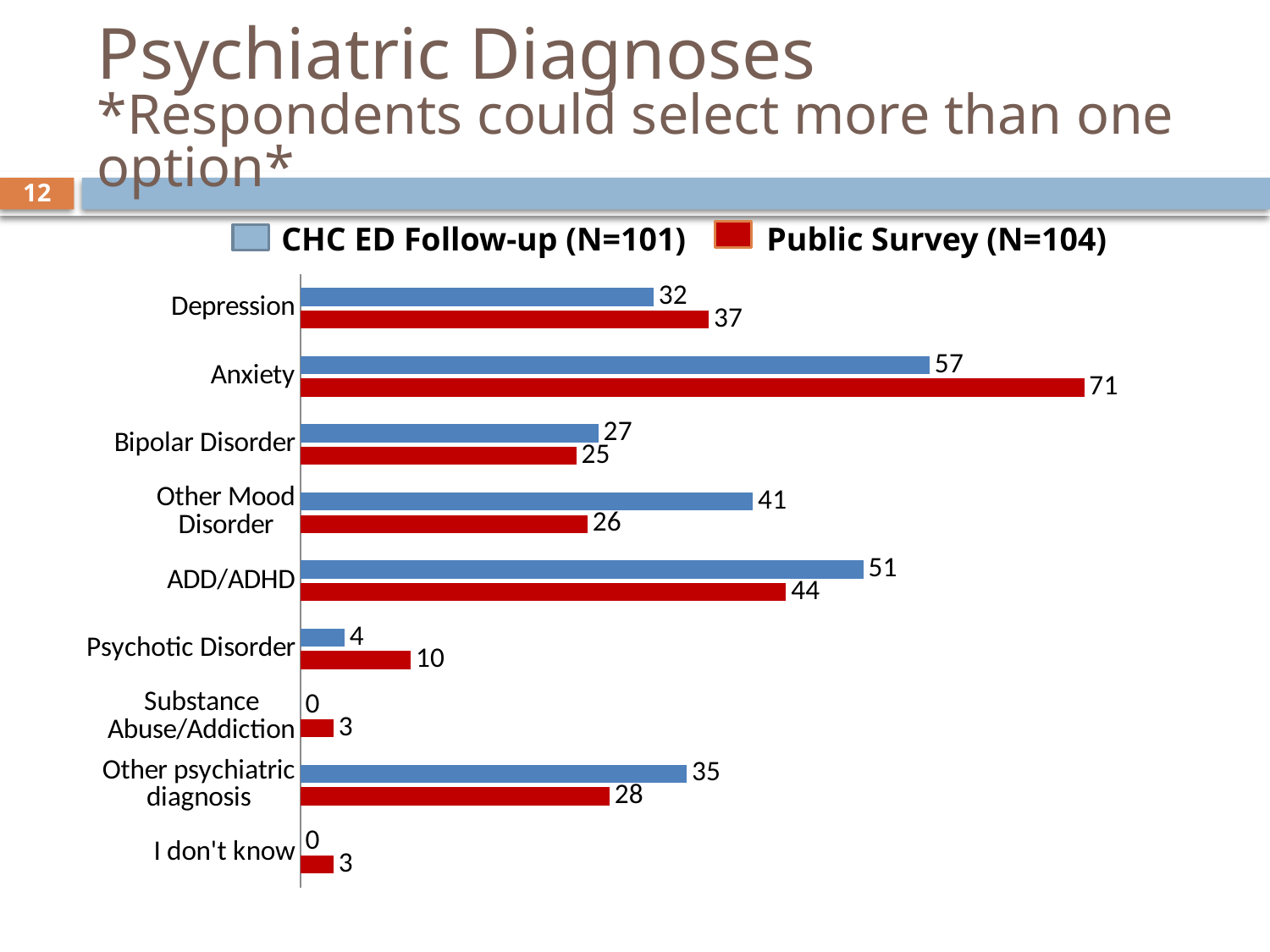
Which category has the lowest CHC ED Follow-up value? Substance Abuse/Addiction and I don't know (both 0) What kind of chart is shown on the slide? Bar chart How many diagnosis categories are shown on the chart? 9 What is the Public Survey value for Depression? 37 What is the difference between the Public Survey and CHC ED Follow-up values for Anxiety? 14 For ADD/ADHD, which series has the larger value, CHC ED Follow-up or Public Survey? CHC ED Follow-up For Bipolar Disorder, which series has the larger value, CHC ED Follow-up or Public Survey? CHC ED Follow-up What is the difference between the CHC ED Follow-up and Public Survey values for Other Mood Disorder? 15 Which category has the highest Public Survey value? Anxiety What is the CHC ED Follow-up value for Anxiety? 57 How many series does the legend list? 2 What is the Public Survey value for Psychotic Disorder? 10